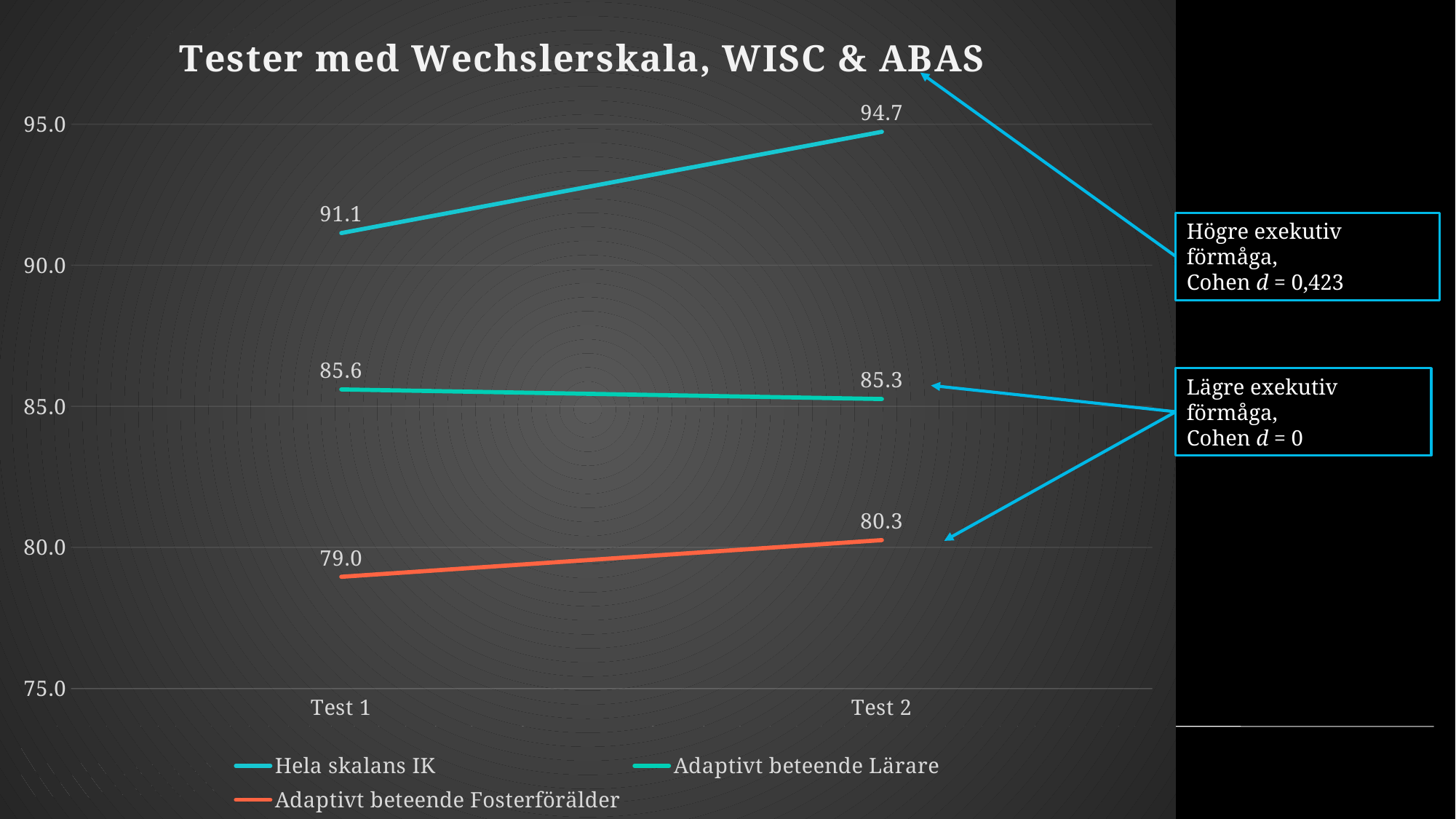
How many series does the legend list? 3 Which is larger: Adaptivt beteende Lärare at Test 1 or at Test 2? Test 1 Does Adaptivt beteende Lärare rise or fall from Test 1 to Test 2? Fall Is the value for Adaptivt beteende Fosterförälder at Test 1 greater or less than 80.0? less By how much does Hela skalans IK increase from Test 1 to Test 2? 3.6 What is the value of Hela skalans IK at Test 2? 94.7 What kind of chart is shown on the slide? Line chart What is the value of Adaptivt beteende Fosterförälder at Test 1? 79.0 Which series has the lowest value at Test 1? Adaptivt beteende Fosterförälder What is the value of Adaptivt beteende Lärare at Test 2? 85.3 Which series has the highest value at Test 2? Hela skalans IK What is the difference between Adaptivt beteende Lärare and Adaptivt beteende Fosterförälder at Test 2? 5.0